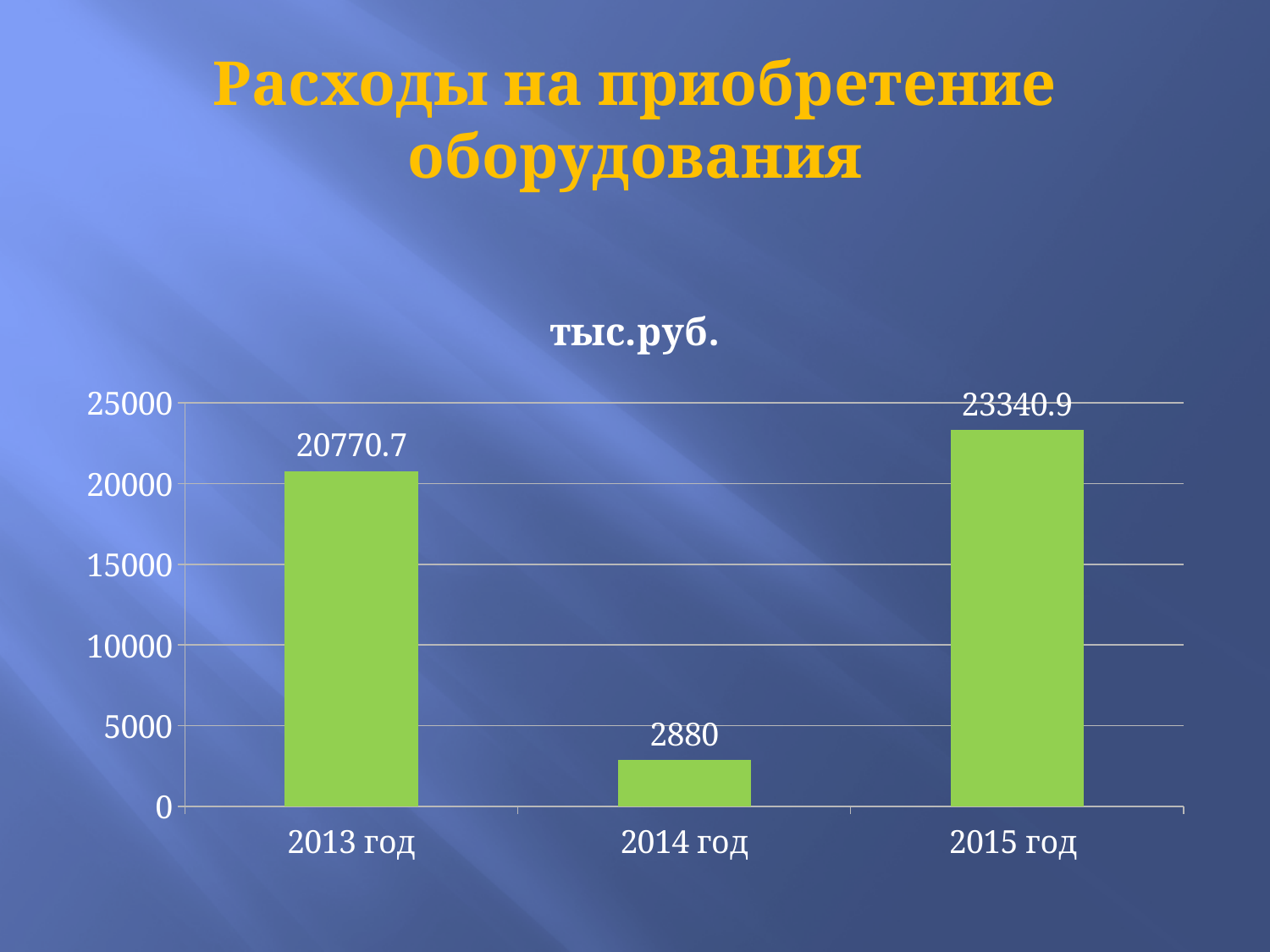
What kind of chart is shown on the slide? bar chart Which year has the lowest value? 2014 год How many categories are shown on the x axis? 3 Which year has the highest value? 2015 год What is the difference between the values for 2015 год and 2013 год? 2570.2 What is the value for 2015 год? 23340.9 Is the value for 2014 год greater or less than 5000? less What is the title of the chart? тыс.руб. What is the value for 2014 год? 2880 What is the value for 2013 год? 20770.7 What is the difference between the values for 2013 год and 2014 год? 17890.7 Which is larger, the value for 2013 год or the value for 2014 год? 2013 год